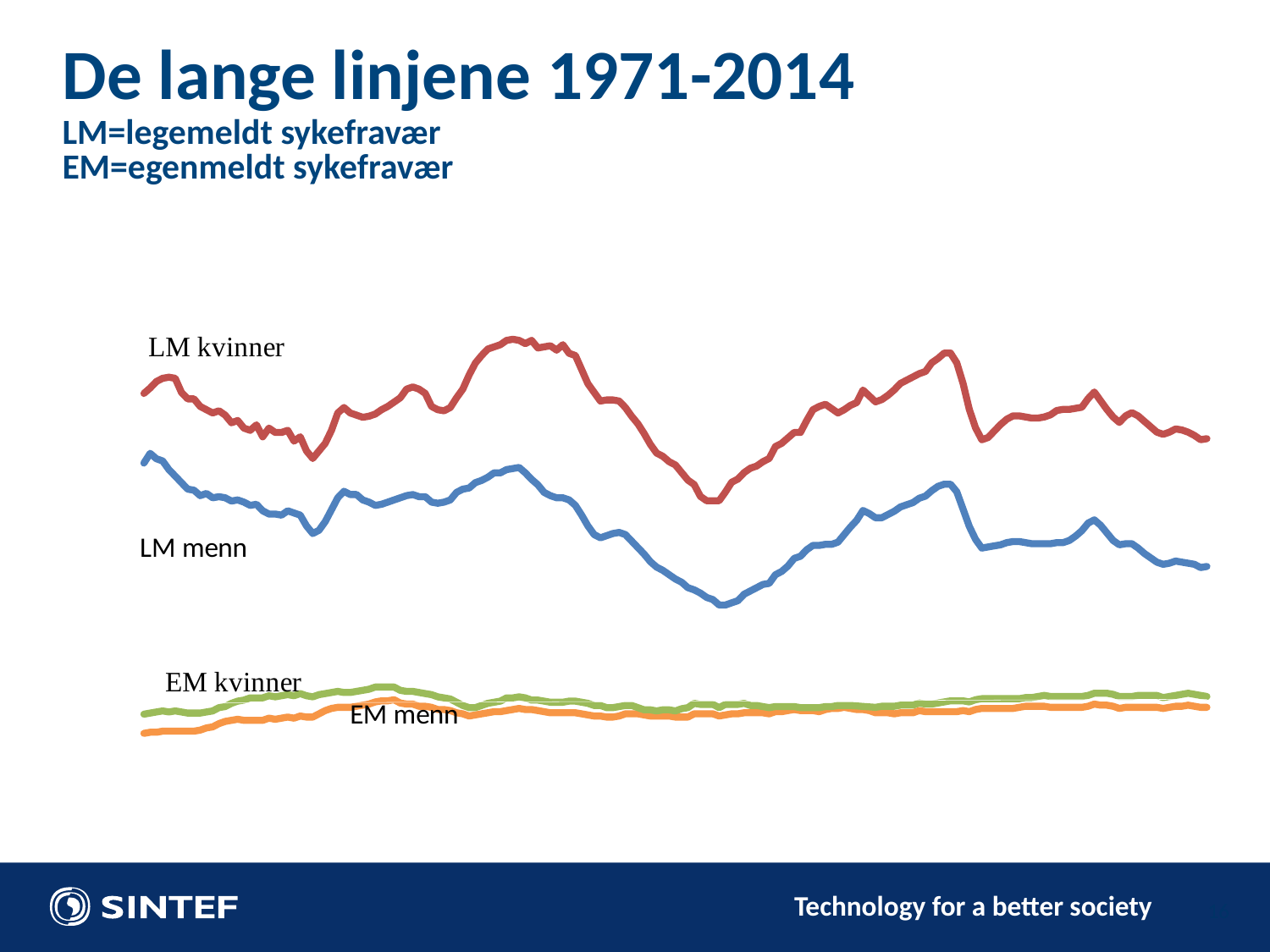
Which series is higher, LM menn or EM kvinner? LM menn What period does the chart title say the lines cover? 1971-2014 What kind of chart is shown on the slide? line chart Which series is higher, EM kvinner or EM menn? EM kvinner Which series lies lowest on the chart across the whole period? EM menn Which series is higher, LM kvinner or LM menn? LM kvinner What colour is the LM menn line? blue Which series lies highest on the chart across the whole period? LM kvinner What colour is the LM kvinner line? red Which two series show much larger fluctuations over time, the LM series or the EM series? the LM series How many series are plotted on the chart? 4